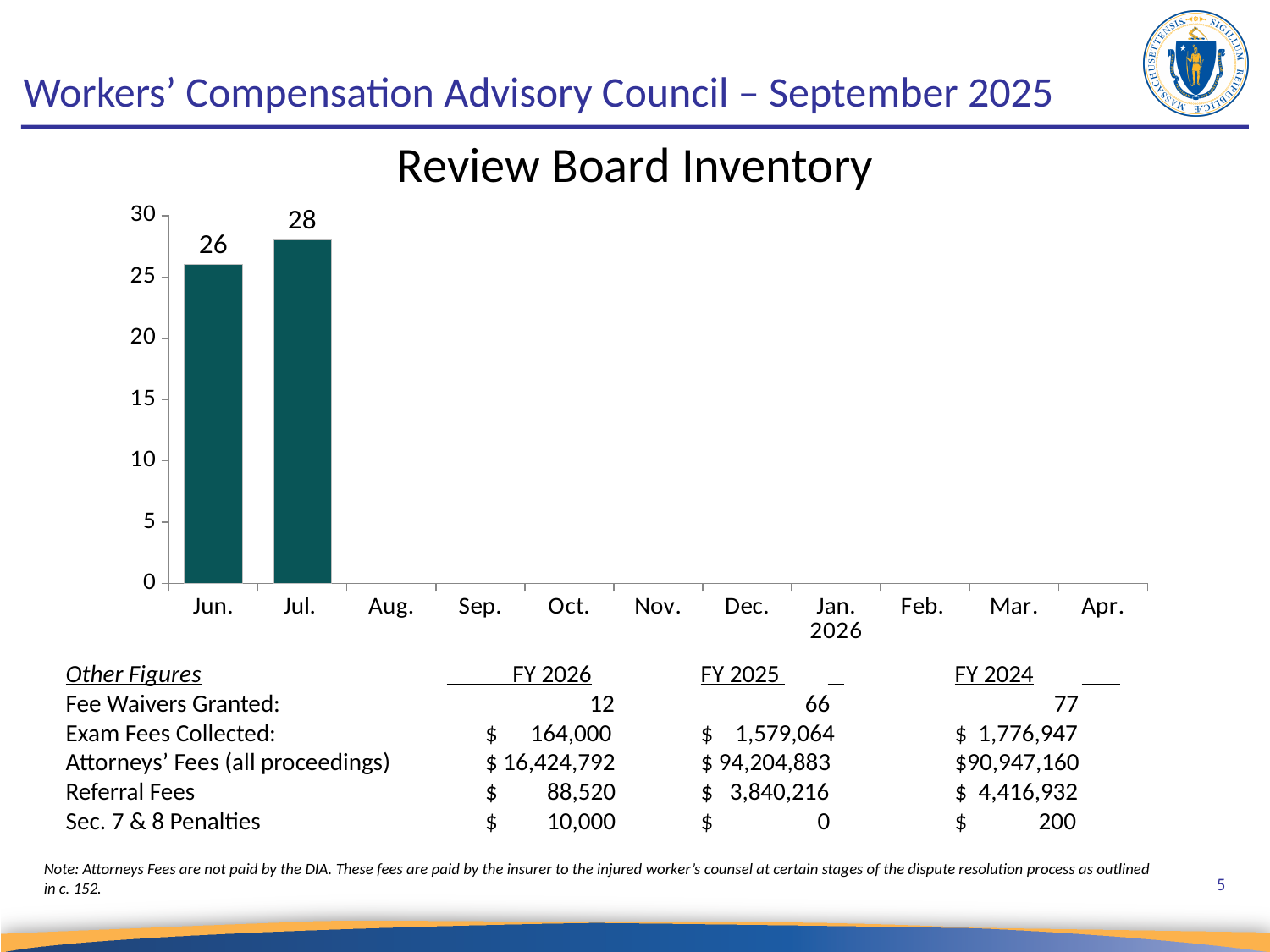
Which month has the higher Review Board Inventory, Jun. or Jul.? Jul. How many month categories are shown on the x axis of the Review Board Inventory chart? 11 What is the difference between the Jul. and Jun. Review Board Inventory values? 2 What is the Review Board Inventory value for Jul.? 28 What is the maximum value shown on the y axis of the Review Board Inventory chart? 30 What kind of chart is the Review Board Inventory chart? bar chart How many months in the Review Board Inventory chart have a plotted bar? 2 What is the Review Board Inventory value for Jun.? 26 Does the Review Board Inventory rise or fall from Jun. to Jul.? rise Is the Review Board Inventory value for Jun. greater or less than 25? greater Is the Review Board Inventory value for Jul. greater or less than 30? less What is the title of the chart on the slide? Review Board Inventory